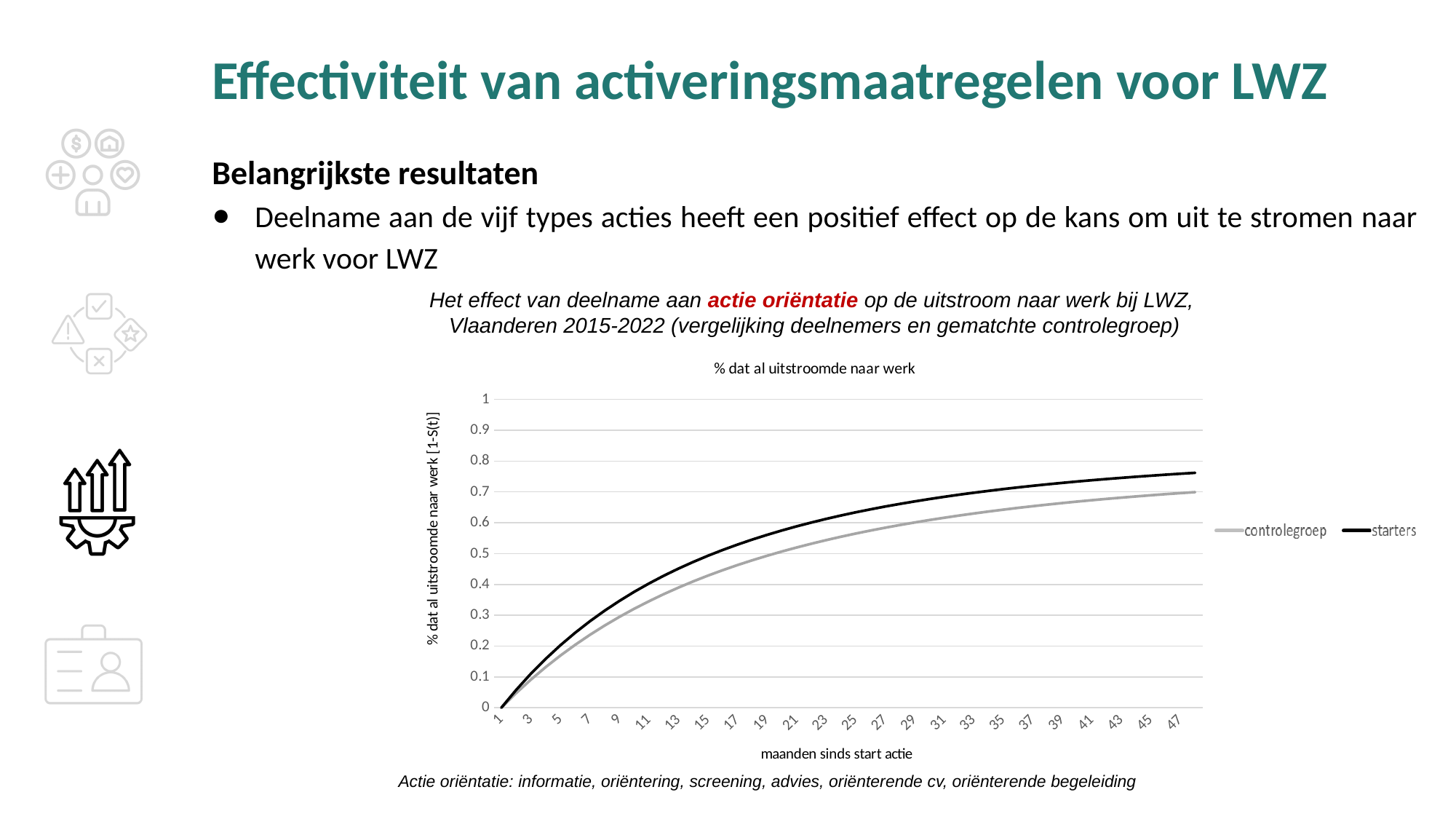
Is the value for starters at month 47 greater or less than 0.7? greater What kind of chart is shown on the slide? line chart Is the value for controlegroep at month 37 greater or less than 0.6? greater How many series does the legend list? 2 Do the values for starters rise or fall as the months since the start of the action increase? rise What is the title printed above the chart? % dat al uitstroomde naar werk Is the value for starters at month 13 greater or less than 0.4? greater Which two series are listed in the legend? controlegroep and starters At month 47, which series has the higher value, starters or controlegroep? starters At month 25, which series has the higher value, controlegroep or starters? starters Do the values for controlegroep rise or fall along the x axis? rise